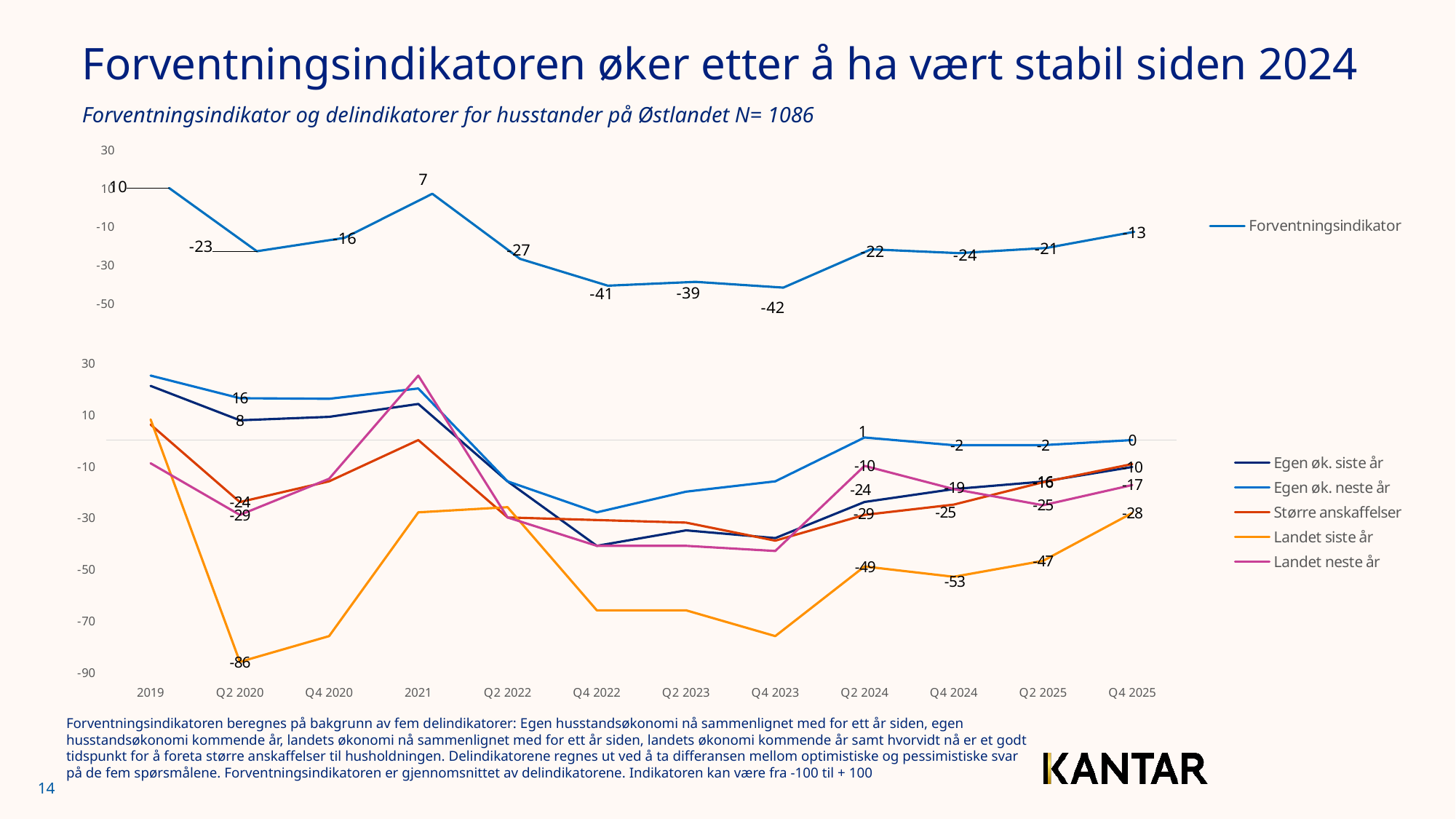
In the top chart (Forventningsindikator), what is the value for 2021? 7 In the bottom chart, what is the value of Landet siste år for Q2 2020? -86 In the top chart (Forventningsindikator), which is higher: the value for Q2 2024 or the value for Q4 2024? Q2 2024 In the bottom chart, what is the value of Landet siste år for Q4 2024? -53 In the bottom chart, what is the value of Egen øk. neste år for Q4 2025? 0 In the top chart (Forventningsindikator), what is the difference between the Q4 2025 value and the Q2 2025 value? 8 In the top chart (Forventningsindikator), what is the value for Q4 2025? -13 How many time periods are shown on the x axis of the bottom chart? 12 In the top chart (Forventningsindikator), which period has the lowest value? Q4 2023 How many series does the legend of the bottom chart list? 5 What kind of chart is the top chart (Forventningsindikator)? Line chart In the bottom chart, which series has the lowest value at Q2 2020? Landet siste år